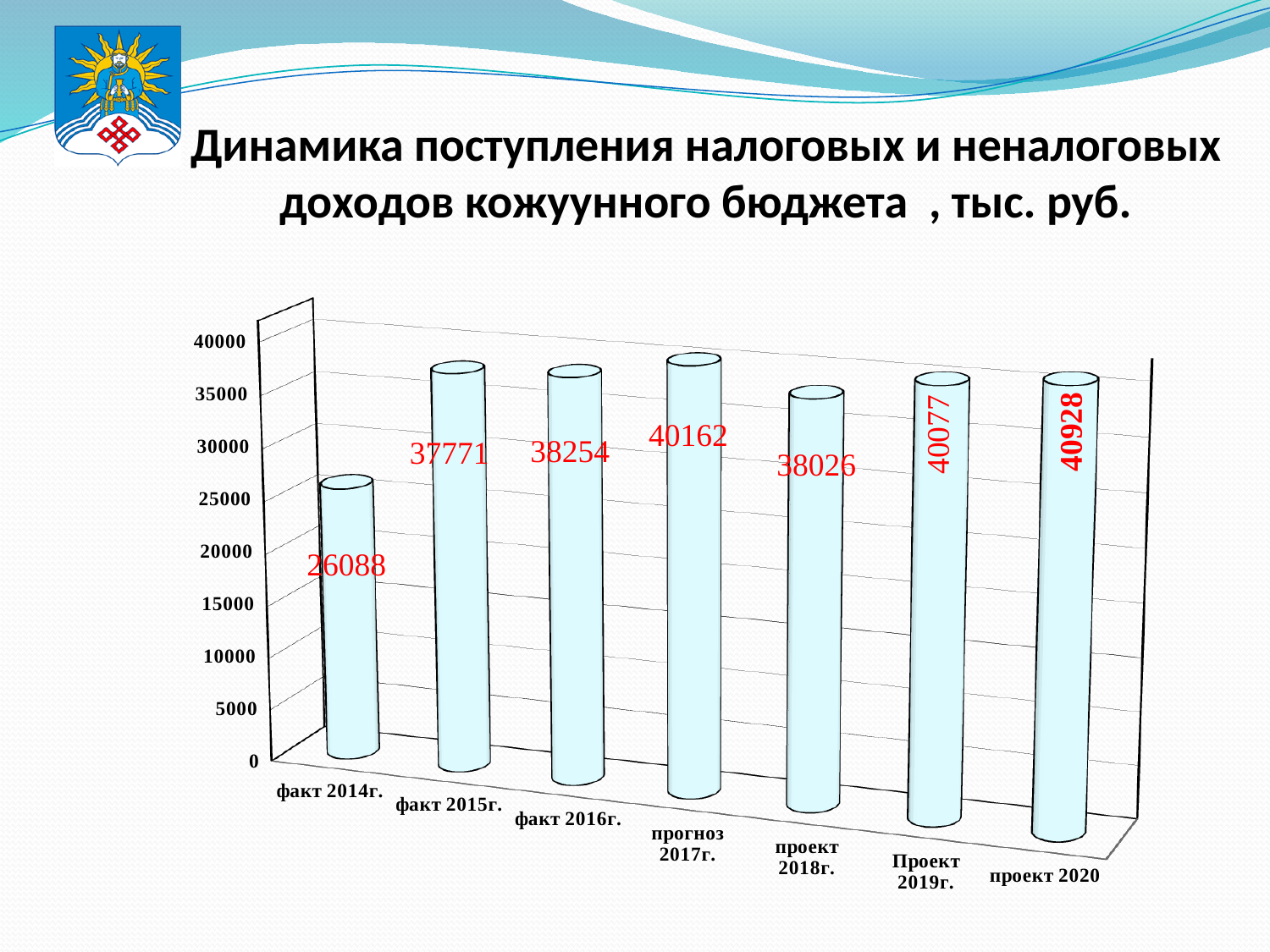
What is the difference between the values for прогноз 2017г. and проект 2018г.? 2136 What is the difference between the values for проект 2020 and факт 2014г.? 14840 What is the value for прогноз 2017г.? 40162 What kind of chart is shown on the slide? bar chart How many categories are shown on the chart? 7 What unit is given in the chart title? тыс. руб. What is the value for проект 2018г.? 38026 Which is larger, the value for факт 2016г. or the value for факт 2015г.? факт 2016г. What is the value for проект 2020? 40928 Which category has the highest value? проект 2020 Which category has the lowest value? факт 2014г. What is the value for факт 2014г.? 26088